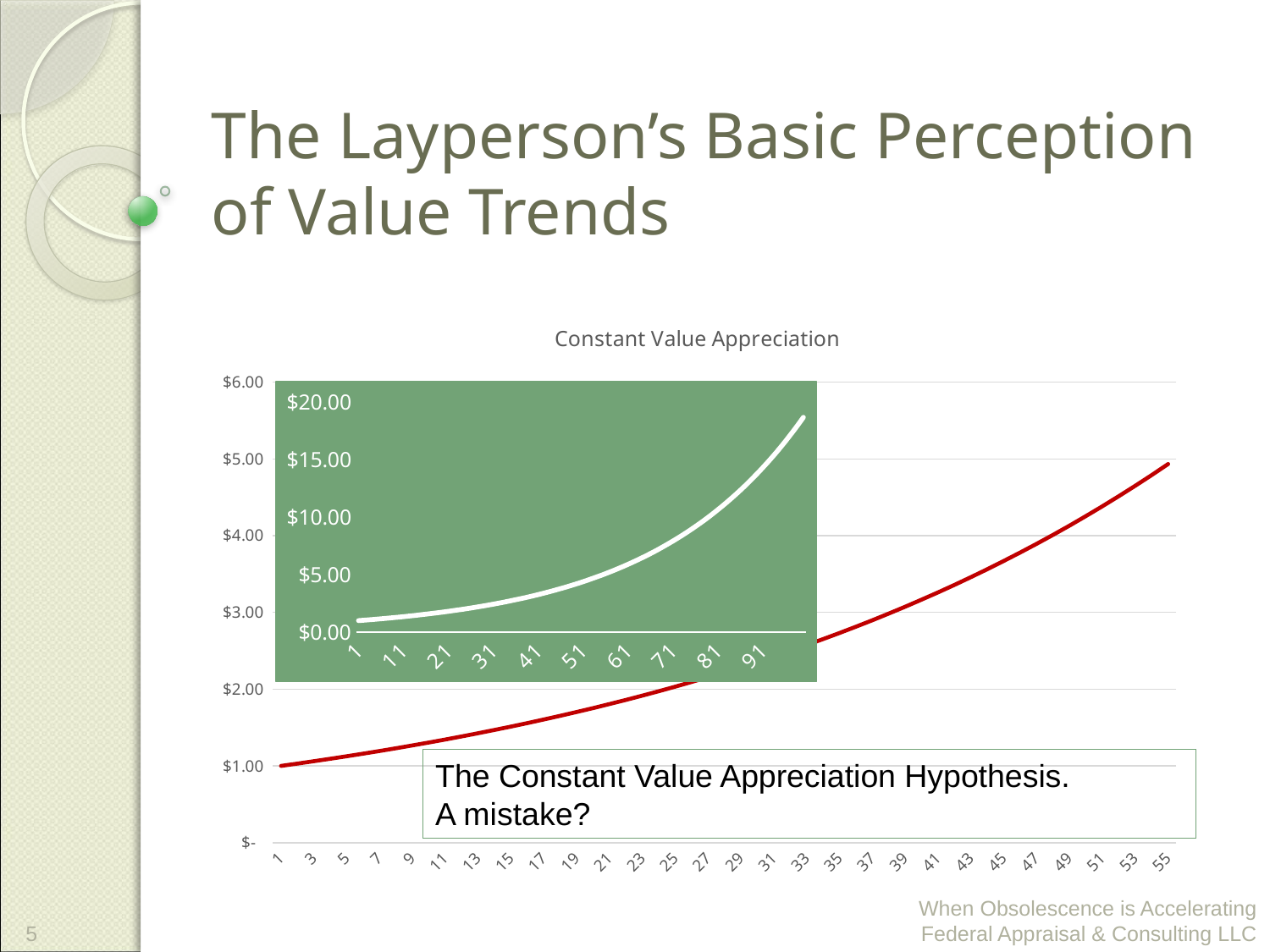
What kind of chart is the small inset chart with the green background? line chart In the large 'Constant Value Appreciation' chart, is the value at x = 51 greater or less than $4.00? greater What kind of chart is the large chart titled 'Constant Value Appreciation'? line chart In the large 'Constant Value Appreciation' chart, do the values rise or fall as the x axis goes from 1 to 55? rise In the large 'Constant Value Appreciation' chart, is the value at x = 11 greater or less than $2.00? less What colour is the line in the large 'Constant Value Appreciation' chart? red In the large 'Constant Value Appreciation' chart, is the value at x = 45 greater or less than $3.00? greater What is the title of the large chart on the slide? Constant Value Appreciation In the small inset chart with the green background, do the values rise or fall along the x axis from 1 to 91? rise